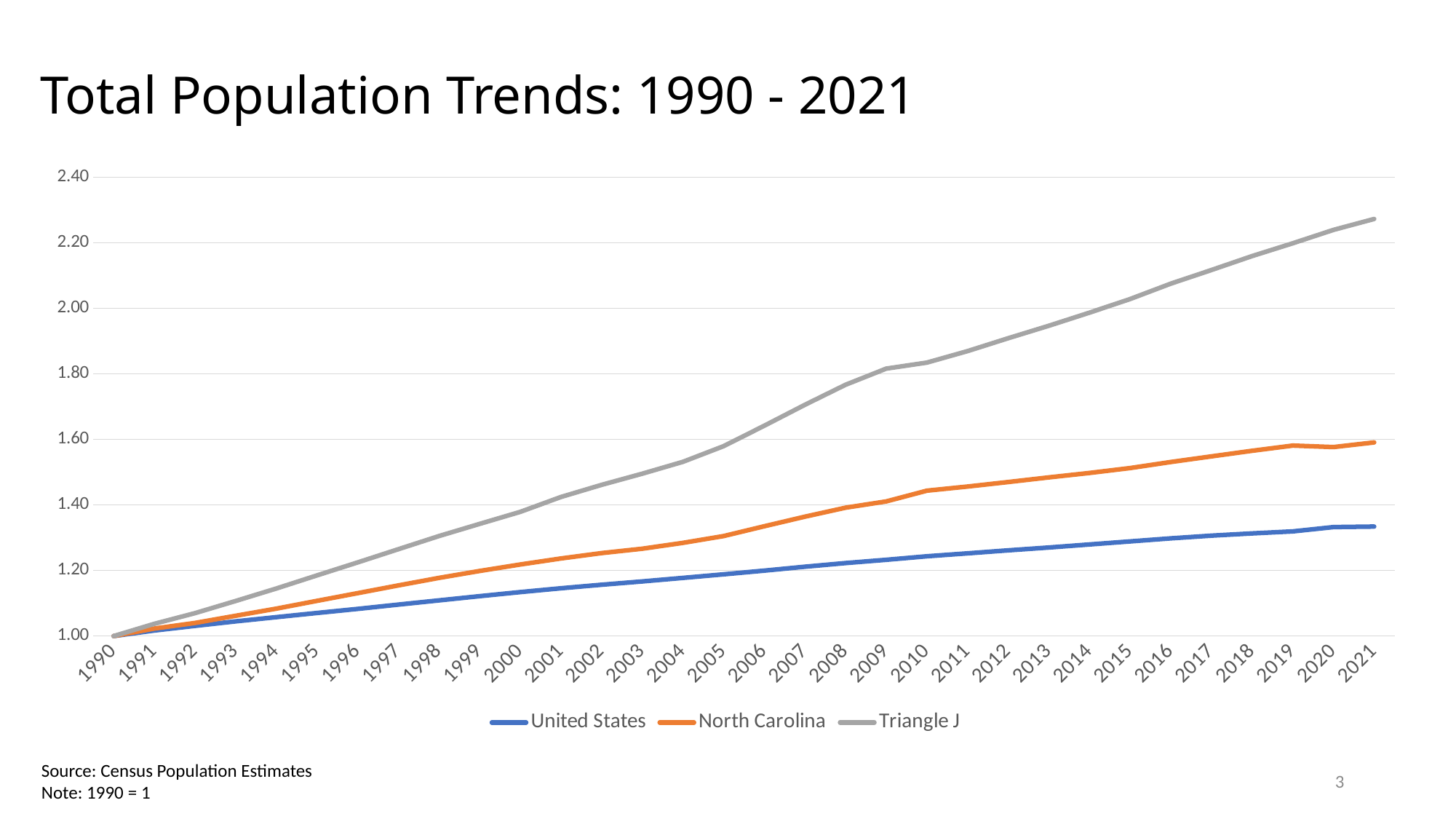
In 2010, which is larger: the value for North Carolina or the value for United States? North Carolina What kind of chart is shown on the slide? line chart What is the value for Triangle J in 1990? 1.00 How many years are plotted along the x axis? 32 Which series has the lowest value in 2021? United States Is the value for North Carolina in 2021 greater or less than 1.40? greater Is the value for United States in 2021 greater or less than 1.40? less Which series has the highest value in 2021? Triangle J Is the value for Triangle J in 2021 greater or less than 2.20? greater Do the values for Triangle J rise or fall from 1990 to 2021? rise What is the title of the chart? Total Population Trends: 1990 - 2021 How many series does the legend list? 3